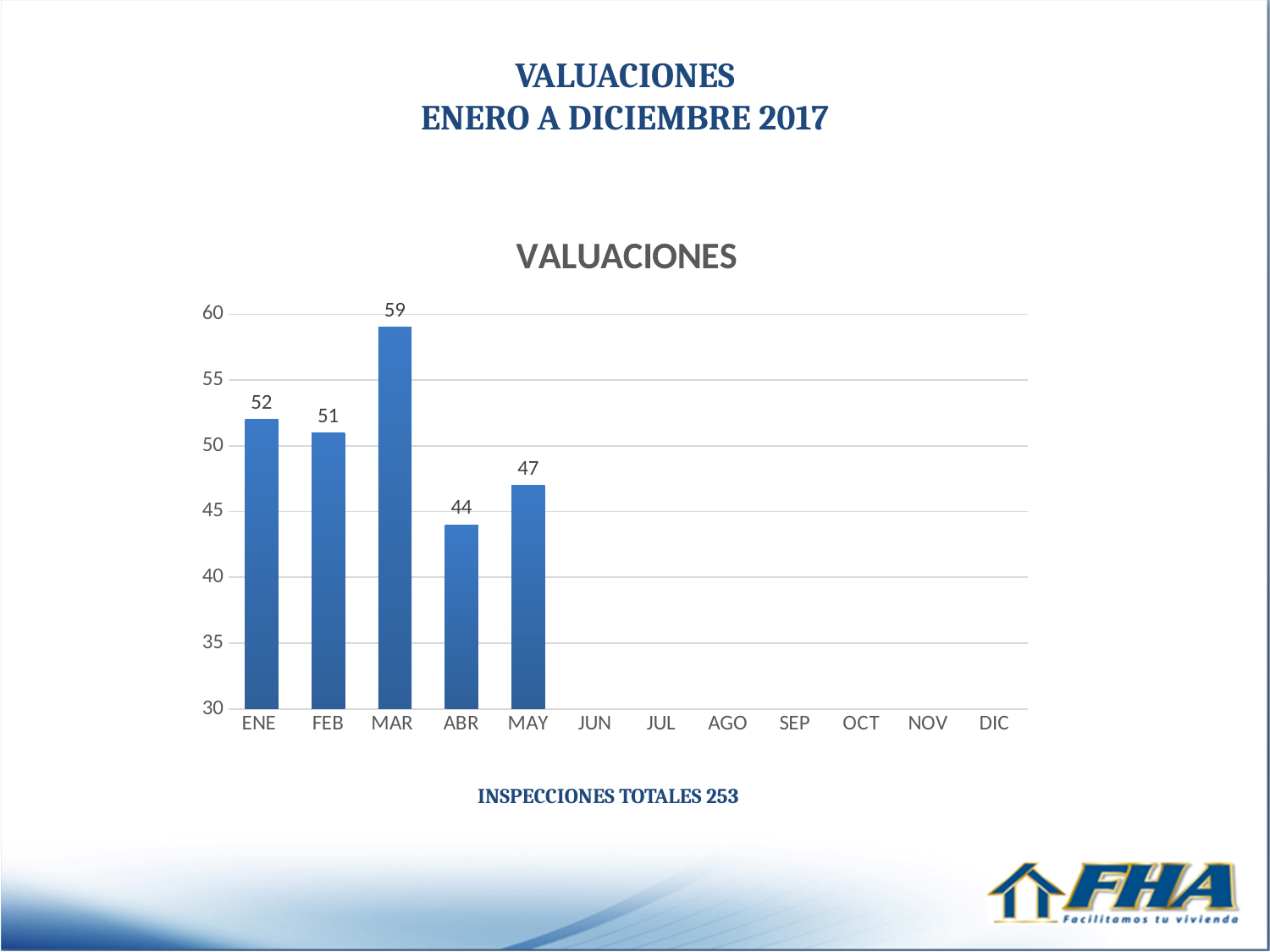
How many months have a bar plotted on the chart? 5 Which month has the highest value? MAR What is the value for ABR? 44 Among the months with plotted bars, which has the lowest value? ABR What is the value for MAR? 59 How many month categories are shown on the x axis? 12 Is the value for MAY greater or less than 50? less Which is larger, the value for FEB or the value for MAY? FEB What is the difference between the values for MAR and ABR? 15 What is the title of the chart? VALUACIONES What is the value for ENE? 52 What kind of chart is shown? bar chart